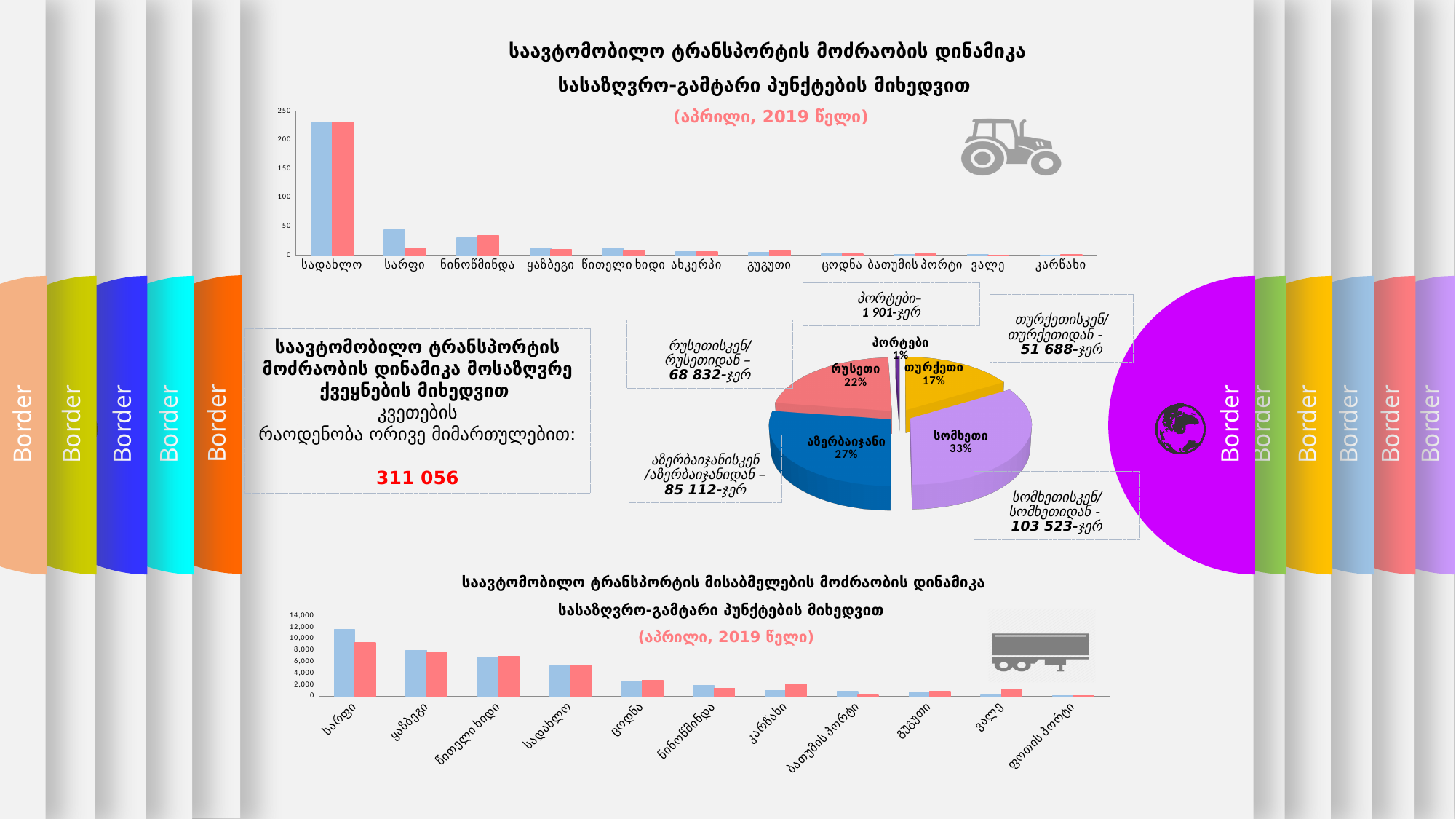
In the top bar chart on the slide, which category has the highest bars? სადახლო What kind of chart is the top chart on the slide? bar chart In the bottom bar chart on the slide, is the value of the blue bar for ყაზბეგი greater or less than 10,000? less In the pie chart in the middle of the slide, which slice is the largest? სომხეთი In the pie chart in the middle of the slide, which slice is the smallest? პორტები In the pie chart in the middle of the slide, what share does სომხეთი have? 33% In the top bar chart on the slide, how many categories are shown on the x axis? 11 In the pie chart in the middle of the slide, what is the difference in percentage points between the shares of სომხეთი and რუსეთი? 11% In the pie chart in the middle of the slide, how many slices are there? 5 In the pie chart in the middle of the slide, which share is larger, თურქეთი or რუსეთი? რუსეთი In the top bar chart on the slide, is the value of the blue bar for სადახლო greater or less than 200? greater In the pie chart in the middle of the slide, what share does აზერბაიჯანი have? 27%